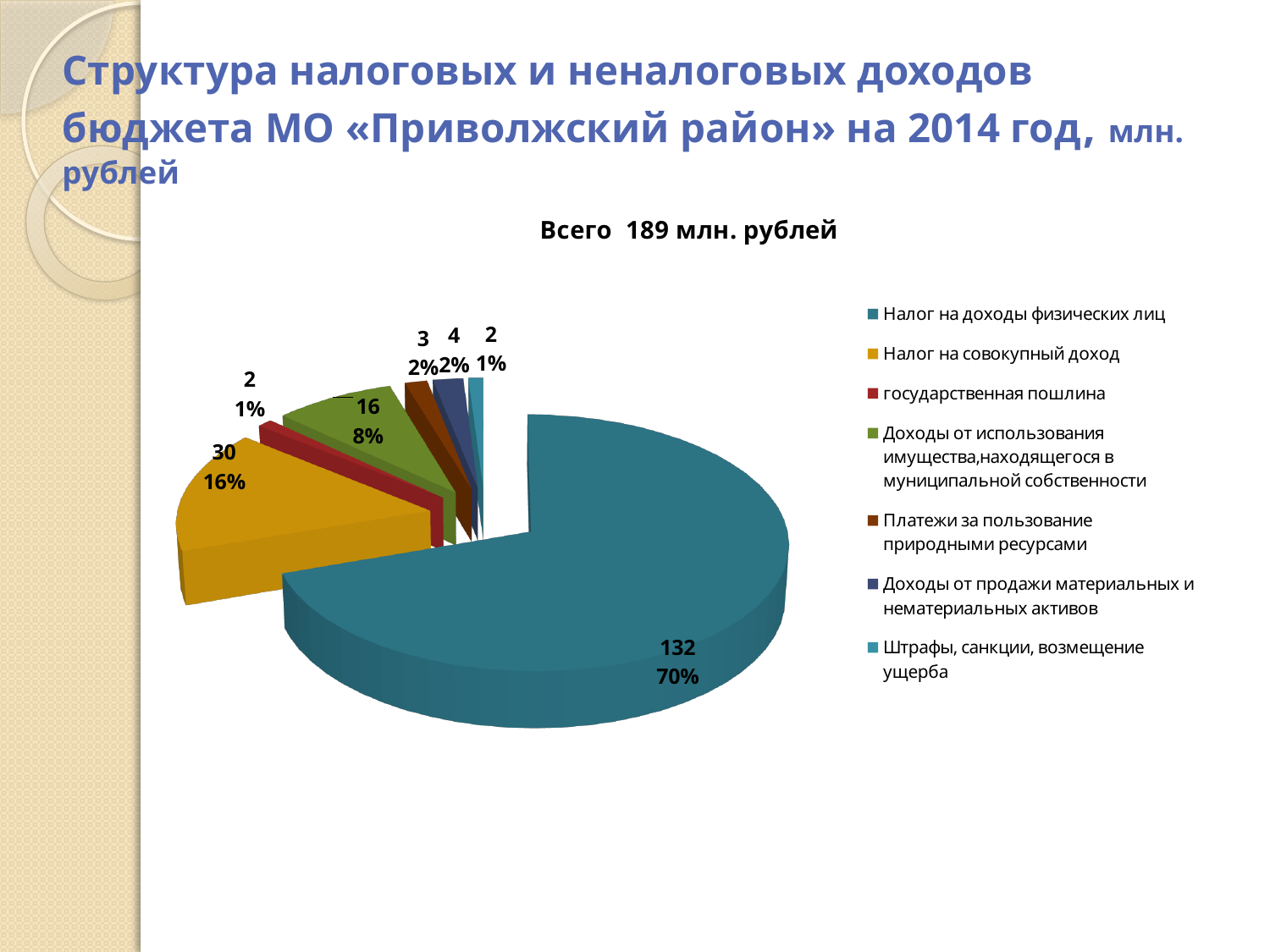
What is the difference between the values for «Налог на доходы физических лиц» and «Налог на совокупный доход»? 102 What share of the pie does «Налог на доходы физических лиц» take? 70% What is the value for «Налог на совокупный доход»? 30 How many categories does the legend list? 7 What is the value for «Доходы от использования имущества, находящегося в муниципальной собственности»? 16 What is the value for «Доходы от продажи материальных и нематериальных активов»? 4 What share of the pie does «Налог на совокупный доход» take? 16% Which category has the largest slice of the pie? Налог на доходы физических лиц What kind of chart is shown on the slide? pie chart What is the value for «Налог на доходы физических лиц»? 132 What total is stated in the chart title? 189 млн. рублей Which is larger: the value for «Платежи за пользование природными ресурсами» or for «Доходы от продажи материальных и нематериальных активов»? Доходы от продажи материальных и нематериальных активов